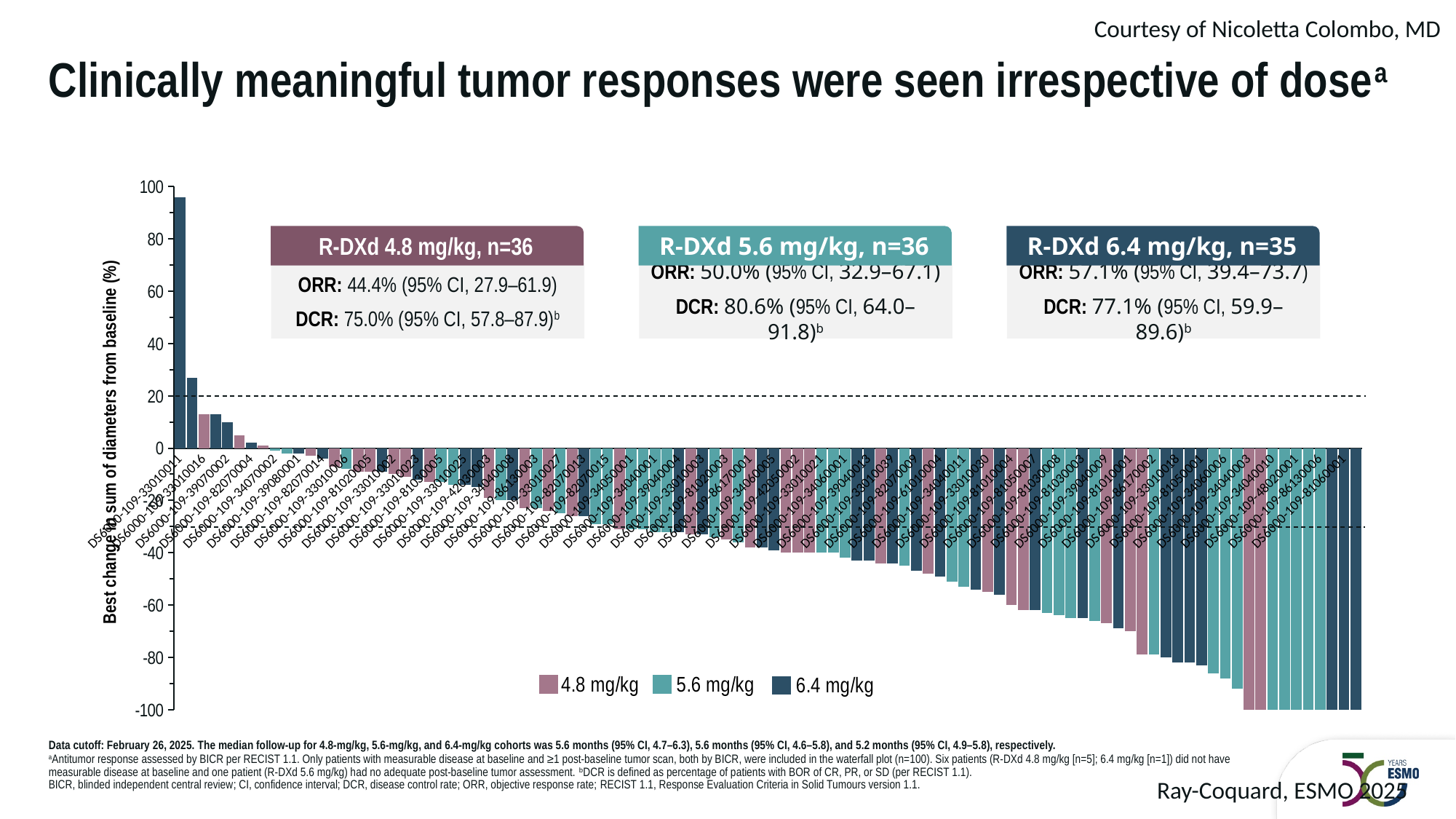
How many series does the chart legend list? 3 What type of chart is shown on the slide? Bar chart Which dose group does the tallest positive bar belong to? 6.4 mg/kg Do the bar values rise or fall moving from left to right along the x axis? Fall According to the footnote, how many patients are included in the waterfall plot? 100 What are the minimum and maximum values shown on the y-axis? -100 and 100 What are the three dose groups listed in the chart legend? 4.8 mg/kg, 5.6 mg/kg, 6.4 mg/kg What is the label of the y-axis? Best change in sum of diameters from baseline (%) Is the value of the second bar from the left greater or less than 20? greater What value do the rightmost bars reach on the y-axis? -100 Is the value of the leftmost (tallest) bar greater or less than 80? greater